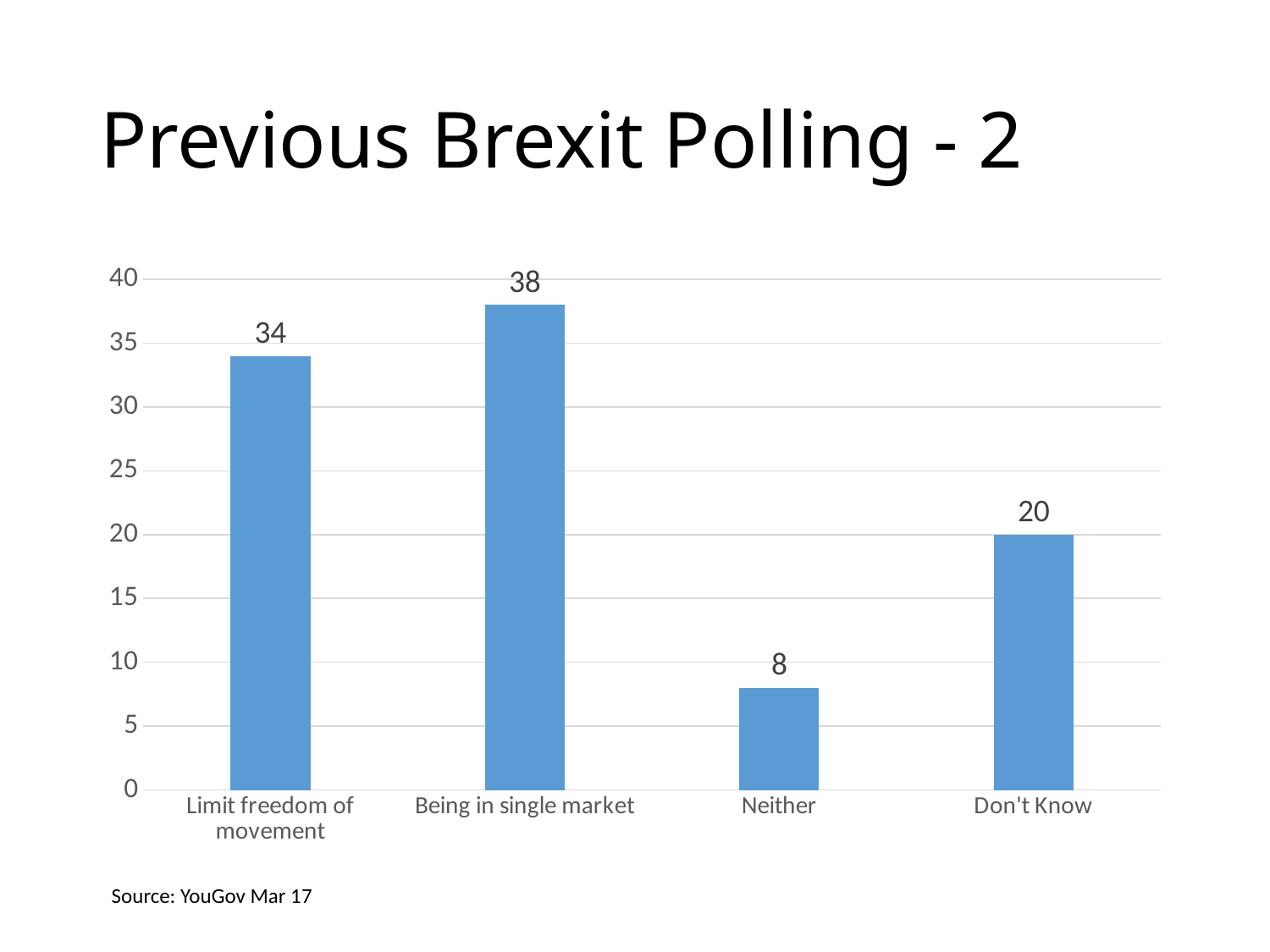
How many categories are shown on the chart? 4 What is the value for "Neither"? 8 What is the difference between the values for "Don't Know" and "Neither"? 12 What is the value for "Limit freedom of movement"? 34 Which is larger, the value for "Don't Know" or the value for "Neither"? Don't Know Which category has the highest value? Being in single market What source is cited below the chart? YouGov Mar 17 What kind of chart is shown on the slide? Bar chart Which category has the lowest value? Neither What is the value for "Being in single market"? 38 What is the value for "Don't Know"? 20 What is the difference between the values for "Being in single market" and "Limit freedom of movement"? 4